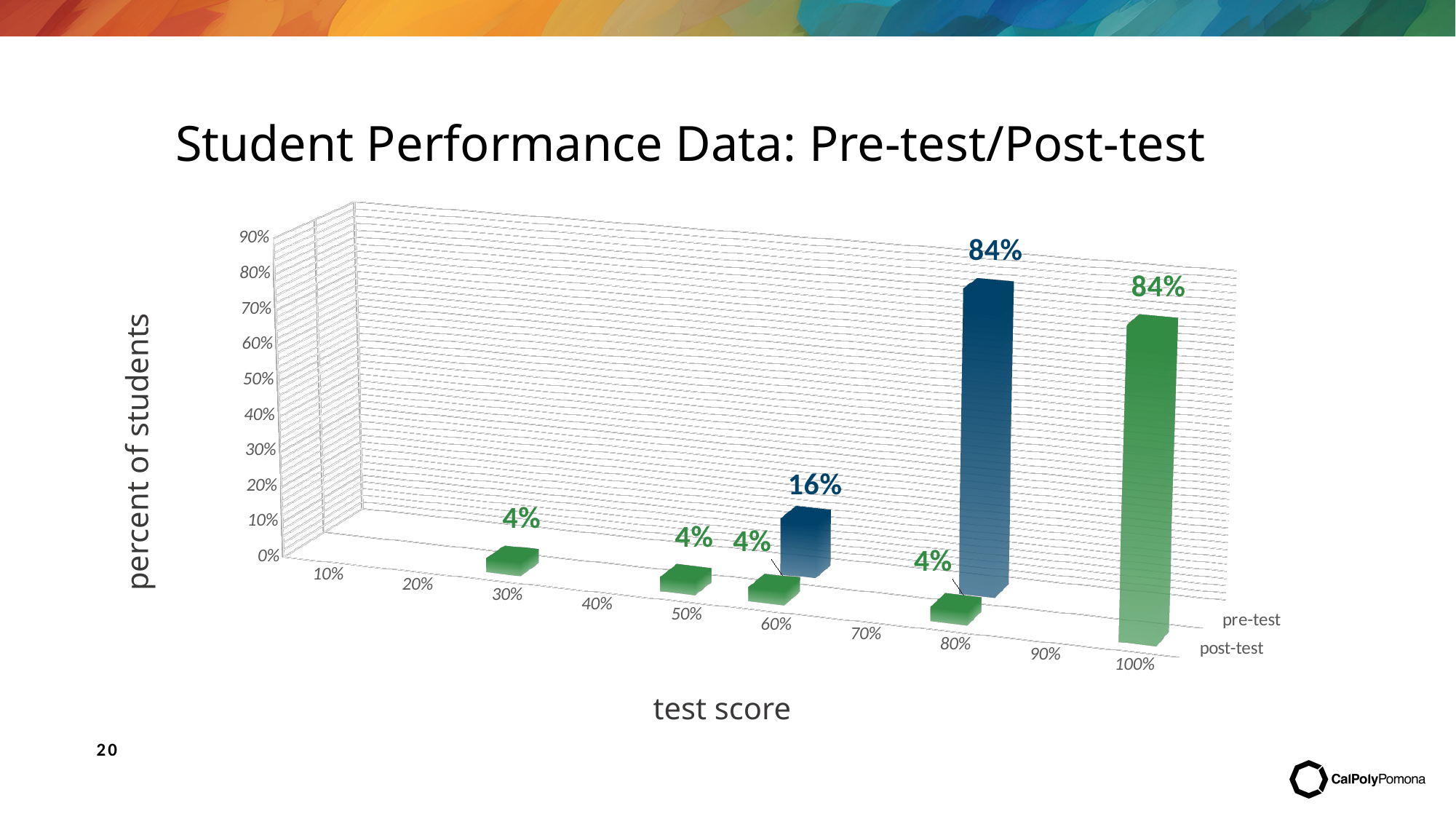
For the 60% test score, which series has the larger value, pre-test or post-test? pre-test How many test score categories are shown on the x axis? 10 Which test score has the highest post-test value? 100% What percent of students scored 100% on the post-test? 84% What is the label of the vertical axis? percent of students What percent of students scored 60% on the pre-test? 16% How many series does the chart show? 2 What percent of students scored 80% on the pre-test? 84% What percent of students scored 30% on the post-test? 4% What kind of chart is shown on the slide? bar chart What is the difference between the pre-test values for the 80% and 60% test scores? 68% Which test score has the highest pre-test value? 80%